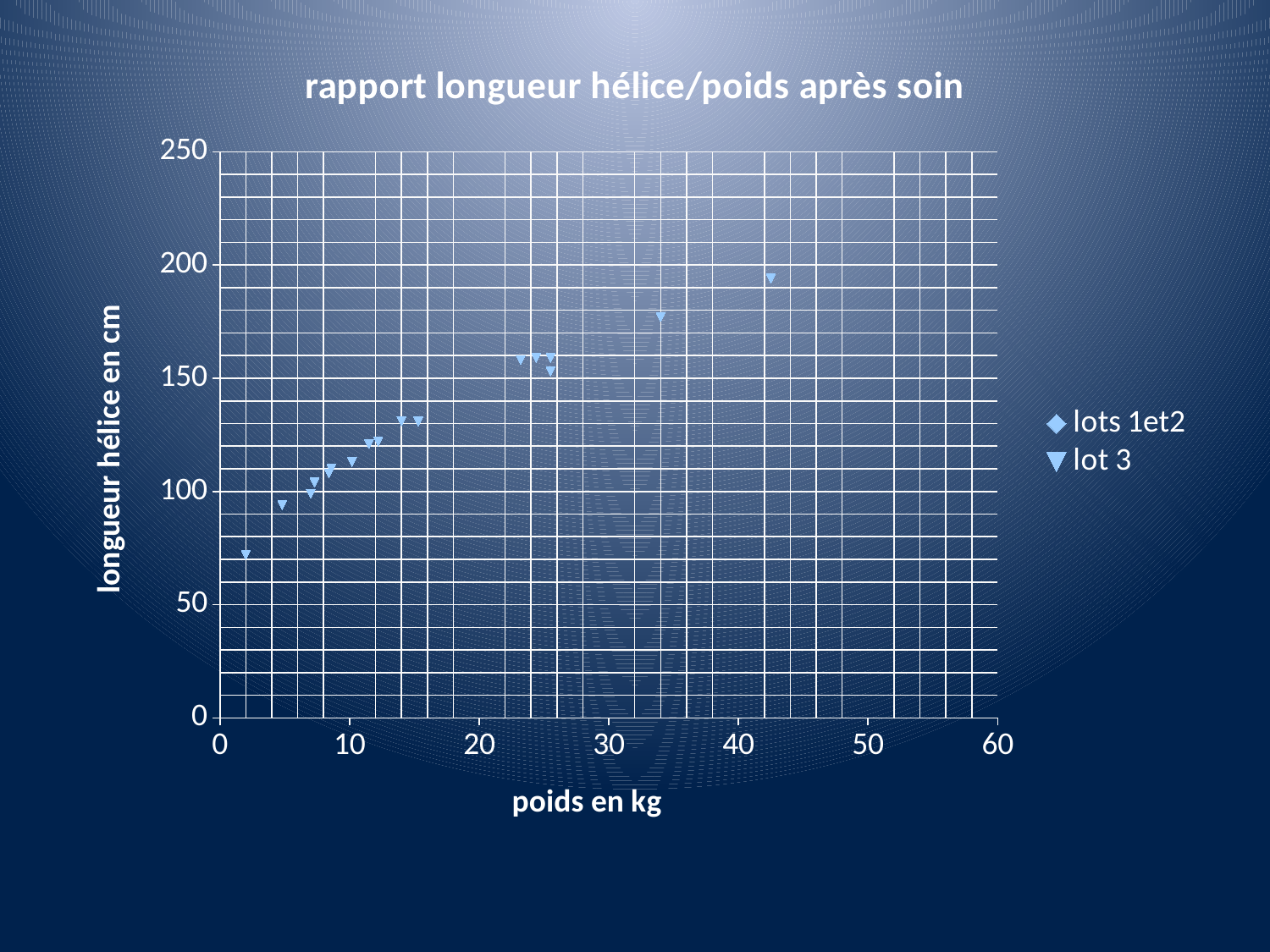
Is the longueur hélice value for the point with the highest weight (around 42 kg) greater or less than 150? greater Which has the larger longueur hélice value: the point at roughly 34 kg or the point at roughly 42 kg? the point at roughly 42 kg Is the longueur hélice value for the point at roughly 34 kg greater or less than 150? greater Do the plotted values rise or fall as weight (poids) increases along the x axis? rise What is the maximum value shown on the vertical axis? 250 What kind of chart is shown on the slide? scatter chart Is the longueur hélice value for the point at roughly 5 kg greater or less than 100? less What is the label of the horizontal axis? poids en kg How many series does the legend list? 2 What is the title of the chart? rapport longueur hélice/poids après soin